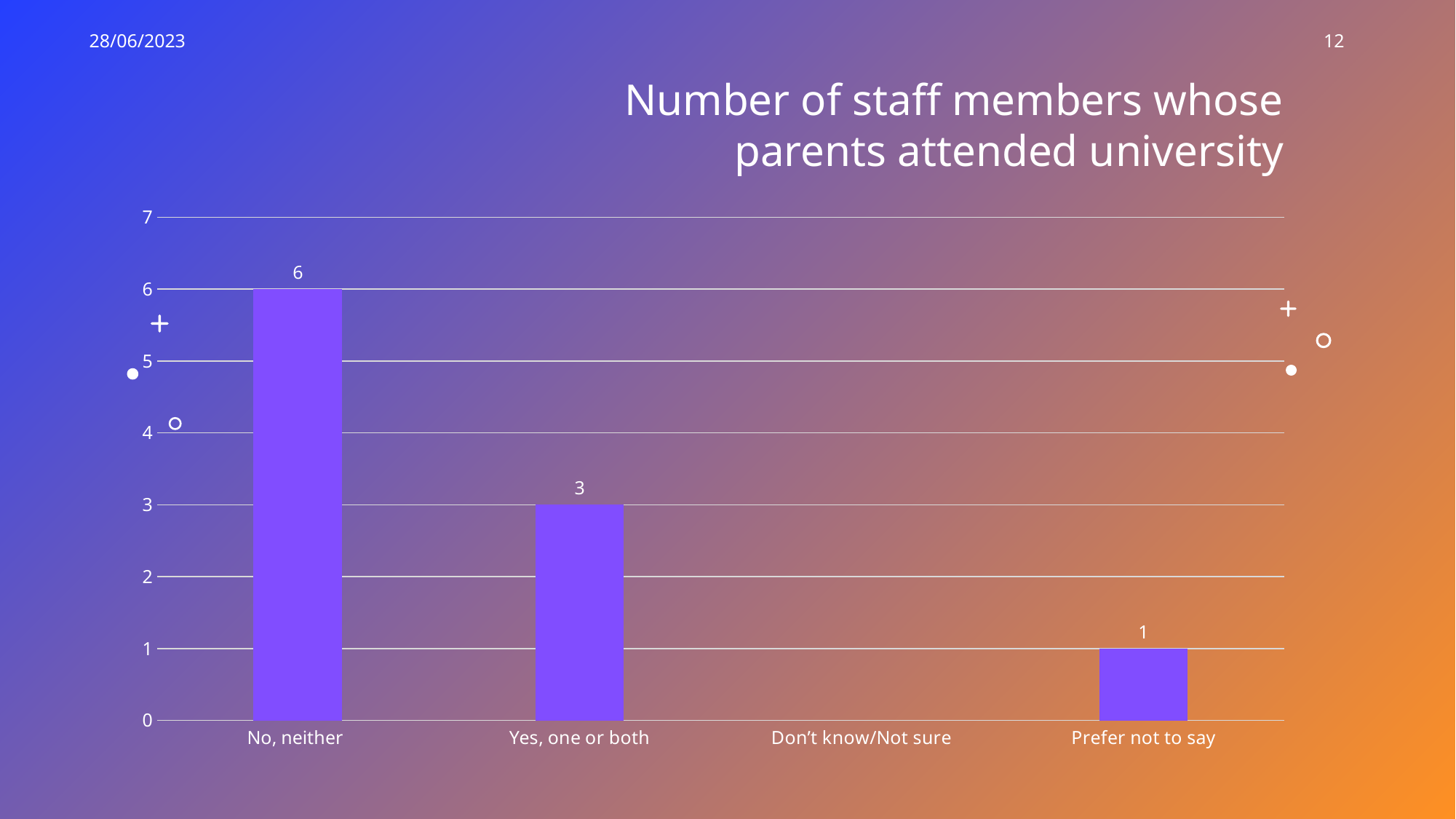
Which category with a visible bar has the lowest value? Prefer not to say How many categories are shown on the x axis? 4 What is the value for "Prefer not to say"? 1 What is the value for "No, neither"? 6 What is the title of the chart? Number of staff members whose parents attended university What is the difference between the values for "Yes, one or both" and "Prefer not to say"? 2 What is the difference between the values for "No, neither" and "Yes, one or both"? 3 Which is larger, the value for "Yes, one or both" or the value for "Prefer not to say"? Yes, one or both What kind of chart is shown on the slide? Bar chart What is the value for "Yes, one or both"? 3 Which category has the highest value? No, neither Is the value for "No, neither" greater or less than 5? greater